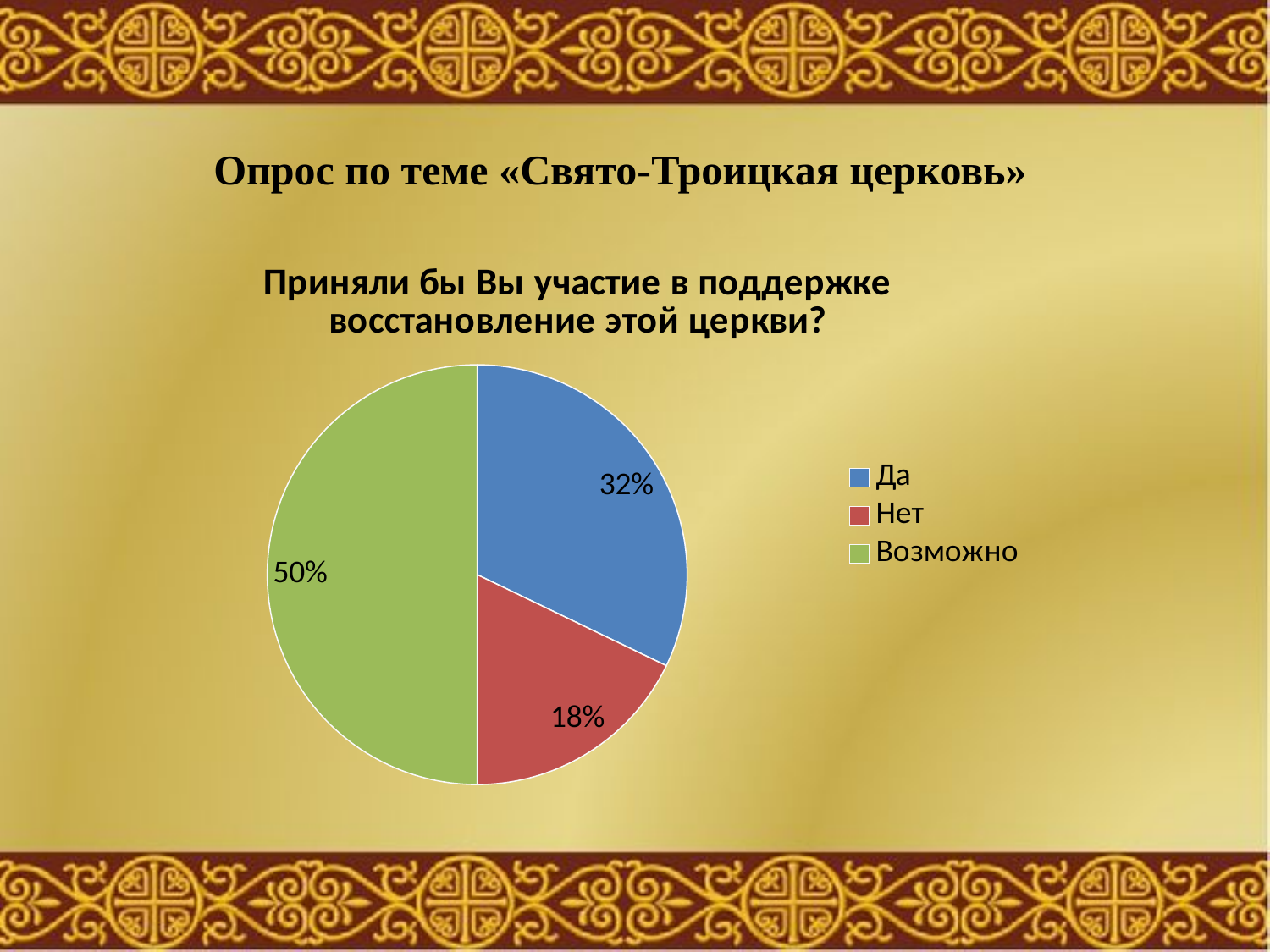
Which is larger, the share for "Да" or the share for "Нет"? Да Which answer option has the smallest share of the pie? Нет What is the difference in percentage points between "Да" and "Нет"? 14 What percentage of respondents answered "Да"? 32% What colour is the slice for "Возможно"? green What percentage of respondents answered "Возможно"? 50% How many entries does the legend list? 3 What is the difference in percentage points between "Возможно" and "Да"? 18 How many slices does the pie chart have? 3 What percentage of respondents answered "Нет"? 18% Which answer option has the largest share of the pie? Возможно What type of chart is shown on the slide? pie chart